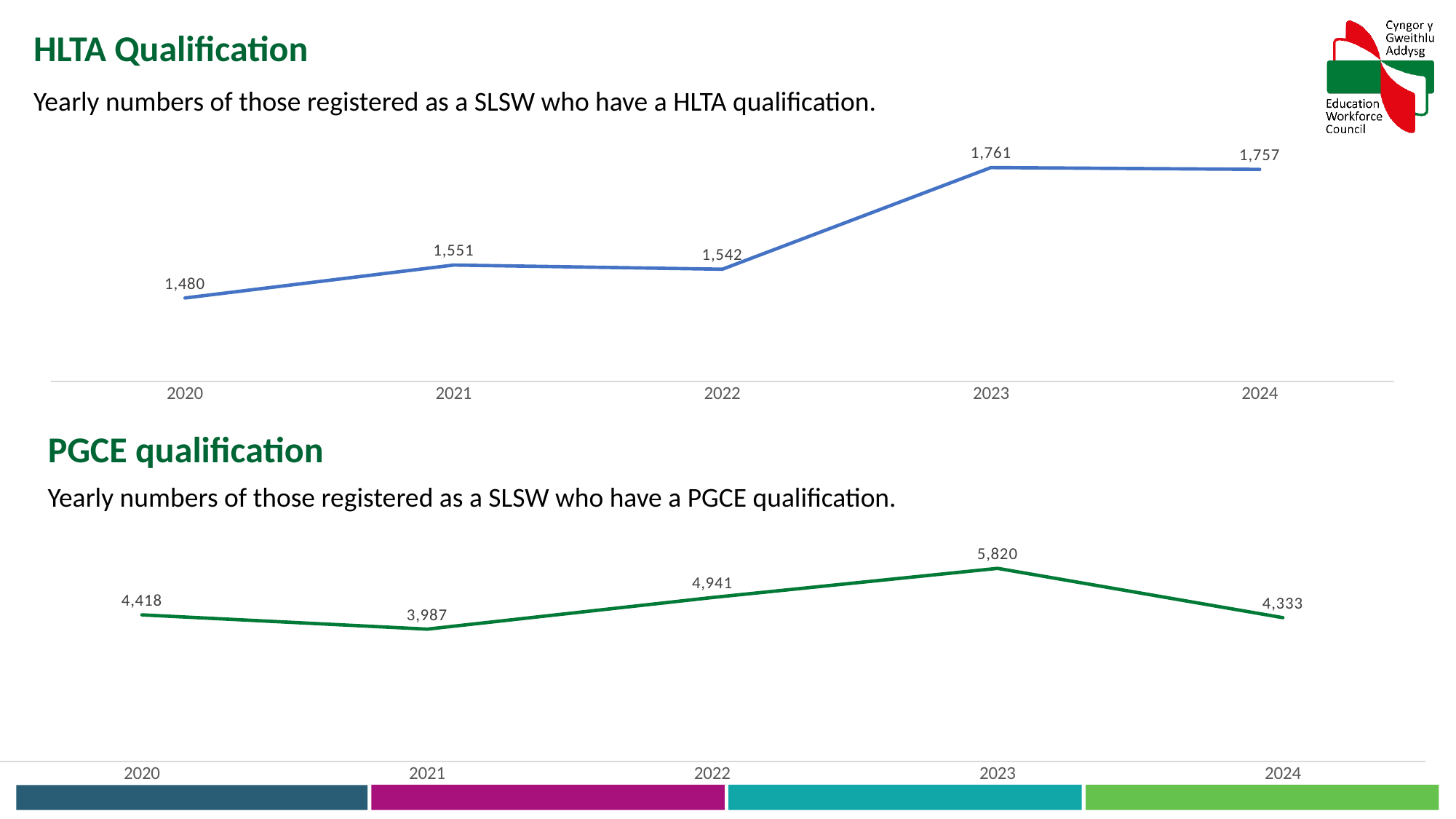
In the HLTA Qualification chart, what is the difference between the 2023 and 2022 values? 219 In the PGCE qualification chart, what is the difference between the 2023 and 2024 values? 1,487 In the HLTA Qualification chart, how many years are plotted? 5 In the HLTA Qualification chart, which year has the lowest value? 2020 In the PGCE qualification chart, which year has the highest value? 2023 What kind of chart is the HLTA Qualification chart? Line chart In the HLTA Qualification chart, what is the value for 2023? 1,761 In the PGCE qualification chart, what is the value for 2022? 4,941 In the PGCE qualification chart, which year has the lowest value? 2021 In the HLTA Qualification chart, what is the value for 2020? 1,480 In the PGCE qualification chart, does the value rise or fall from 2023 to 2024? Fall In the PGCE qualification chart, is the value for 2020 or 2024 larger? 2020